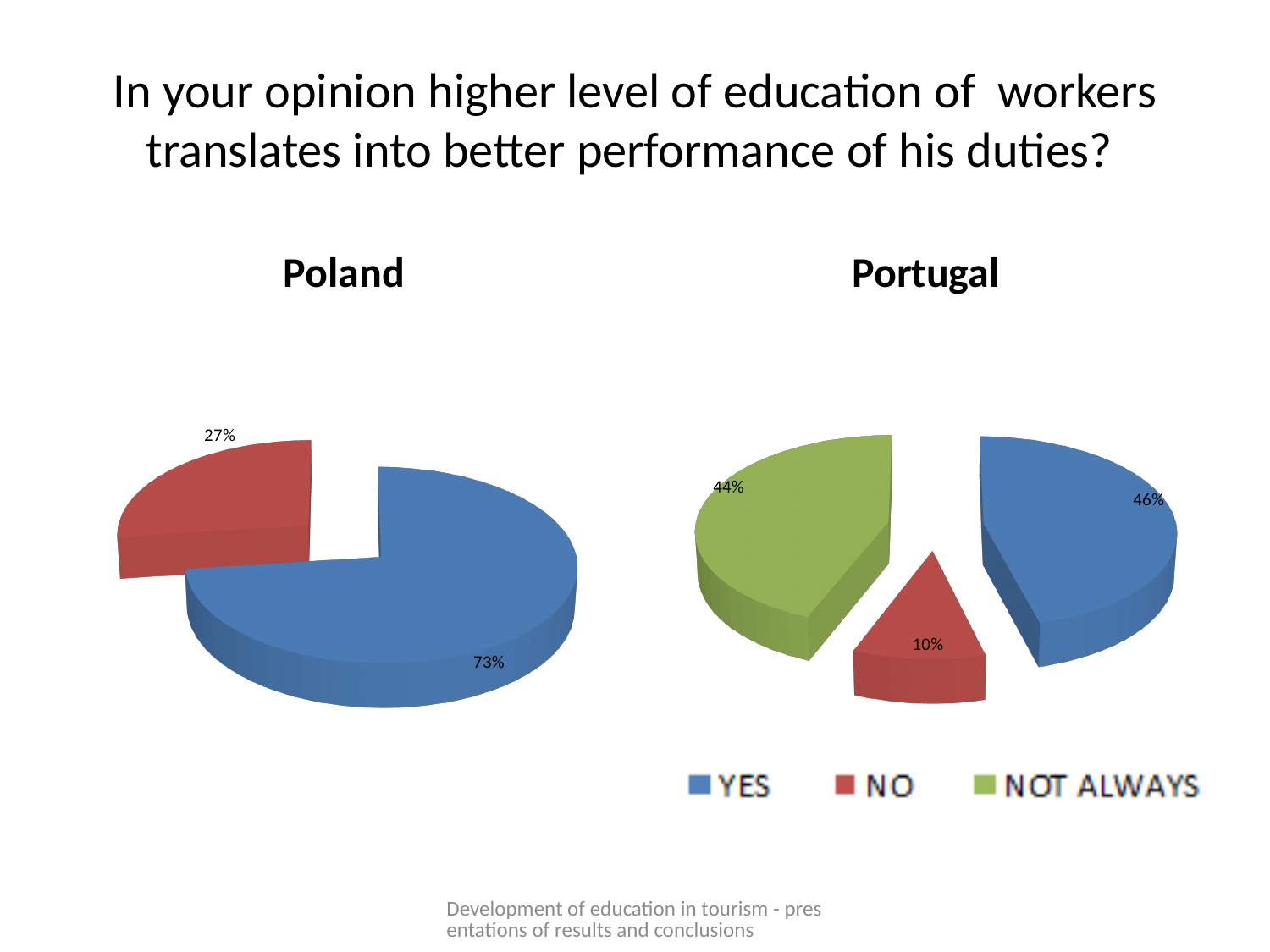
Which is larger: the NO share in the Poland chart or the NO share in the Portugal chart? Poland In the Poland chart, what percentage answered YES? 73% In the Portugal chart, which answer has the smallest share? NO Which colour represents NOT ALWAYS in the legend? Green In the Poland chart, what percentage answered NO? 27% In the Portugal chart, what percentage answered YES? 46% In the Poland chart, which answer has the largest share? YES What is the difference between the YES share in the Poland chart and the YES share in the Portugal chart? 27% How many slices does the Portugal chart have? 3 What type of chart is used for Poland and Portugal? Pie chart In the Portugal chart, what percentage answered NO? 10% In the Portugal chart, what percentage answered NOT ALWAYS? 44%